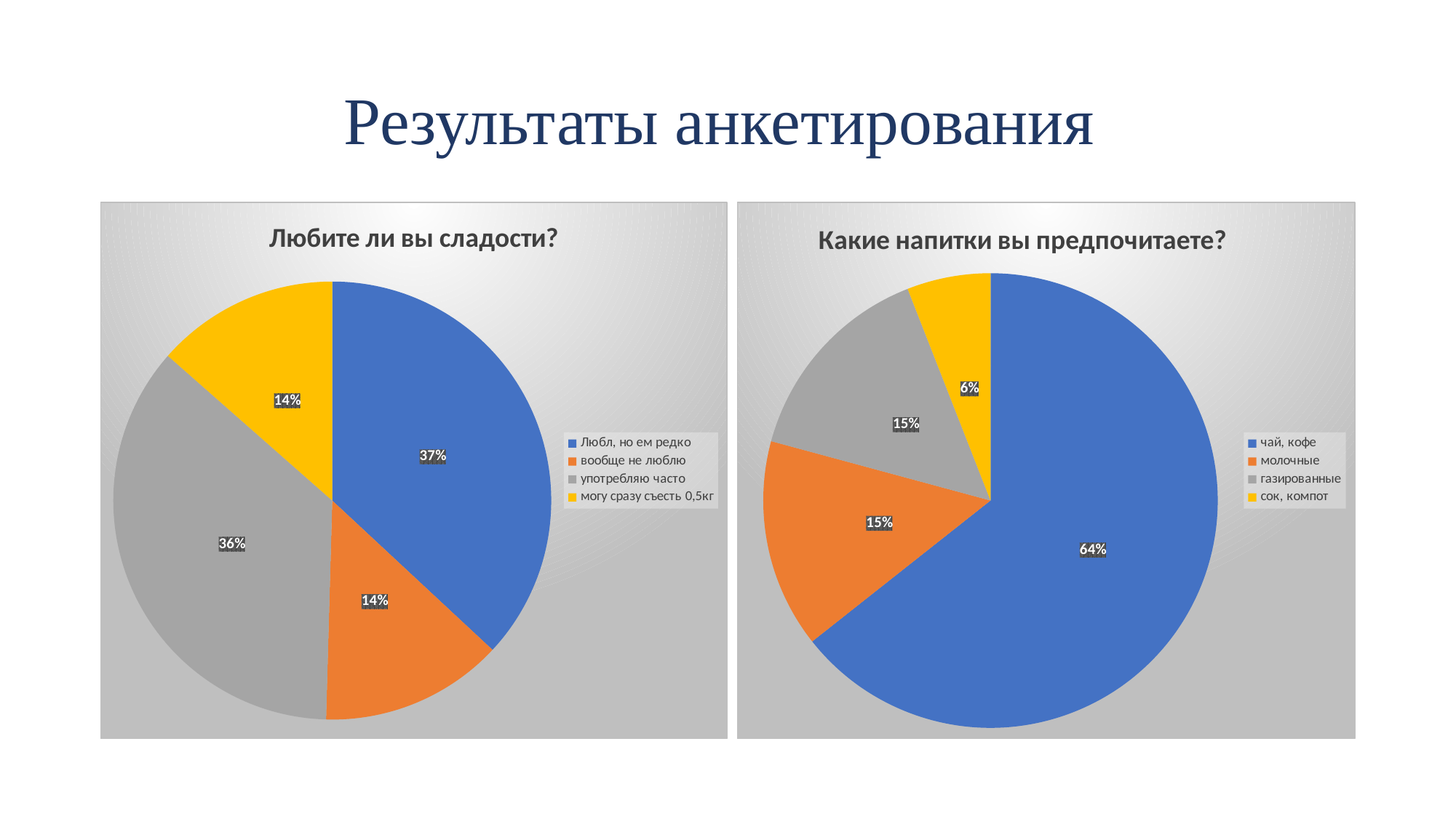
In the chart 'Какие напитки вы предпочитаете?', what is the difference between the shares of 'чай, кофе' and 'газированные'? 49% In the chart 'Какие напитки вы предпочитаете?', which category has the smallest share? сок, компот How many entries does the legend of the chart 'Какие напитки вы предпочитаете?' list? 4 In the chart 'Какие напитки вы предпочитаете?', what colour is the slice for 'газированные'? grey In the chart 'Любите ли вы сладости?', what share is labelled for 'вообще не люблю'? 14% How many slices does the chart 'Любите ли вы сладости?' have? 4 In the chart 'Какие напитки вы предпочитаете?', what share is labelled for 'молочные'? 15% In the chart 'Какие напитки вы предпочитаете?', which category has the largest share? чай, кофе What kind of chart is 'Любите ли вы сладости?'? pie chart In the chart 'Любите ли вы сладости?', what share is labelled for 'употребляю часто'? 36% In the chart 'Какие напитки вы предпочитаете?', which is larger: 'чай, кофе' or 'сок, компот'? чай, кофе